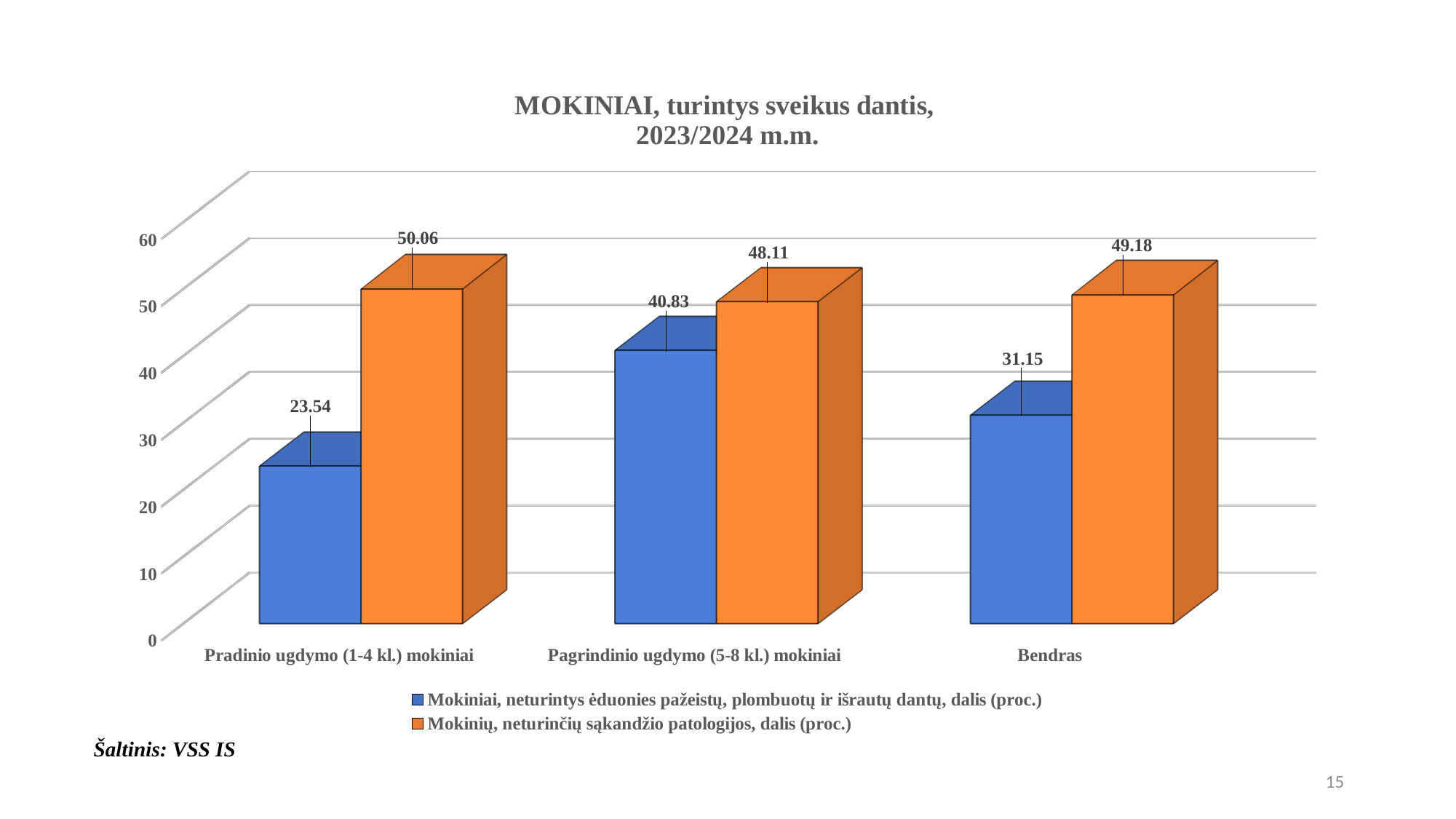
What is the difference between the two series values for Bendras? 18.03 Which category has the lowest value for 'Mokinių, neturinčių sąkandžio patologijos, dalis (proc.)'? Pagrindinio ugdymo (5-8 kl.) mokiniai What is the value for 'Mokinių, neturinčių sąkandžio patologijos, dalis (proc.)' for Pagrindinio ugdymo (5-8 kl.) mokiniai? 48.11 What is the title of the chart? MOKINIAI, turintys sveikus dantis, 2023/2024 m.m. How many categories are shown on the x axis? 3 What kind of chart is shown on the slide? Bar chart How many series does the legend list? 2 Which category has the highest value for 'Mokiniai, neturintys ėduonies pažeistų, plombuotų ir išrautų dantų, dalis (proc.)'? Pagrindinio ugdymo (5-8 kl.) mokiniai What is the value for 'Mokiniai, neturintys ėduonies pažeistų, plombuotų ir išrautų dantų, dalis (proc.)' for Pradinio ugdymo (1-4 kl.) mokiniai? 23.54 What is the difference between the 'Mokiniai, neturintys ėduonies pažeistų, plombuotų ir išrautų dantų, dalis (proc.)' values for Pagrindinio ugdymo (5-8 kl.) mokiniai and Pradinio ugdymo (1-4 kl.) mokiniai? 17.29 Which is larger: the 'Mokinių, neturinčių sąkandžio patologijos, dalis (proc.)' value for Pradinio ugdymo (1-4 kl.) mokiniai or for Bendras? Pradinio ugdymo (1-4 kl.) mokiniai What is the value for 'Mokinių, neturinčių sąkandžio patologijos, dalis (proc.)' for Bendras? 49.18